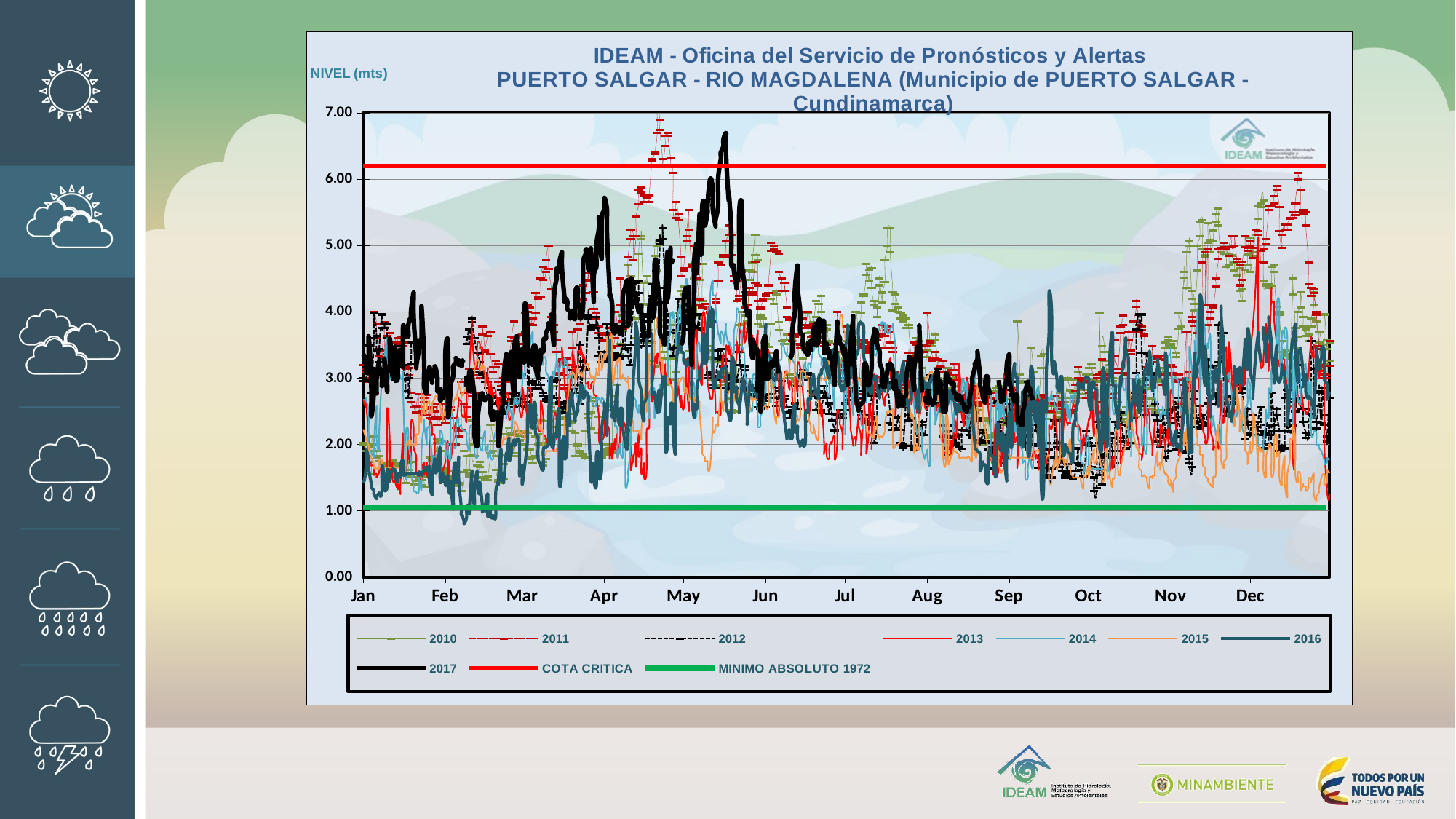
How many months are labelled along the x axis of the chart? 12 Is the highest value of the 2017 series greater or less than 7.00? less Which station and river does the chart title refer to? PUERTO SALGAR - RIO MAGDALENA Which is higher: the COTA CRITICA line or the MINIMO ABSOLUTO 1972 line? COTA CRITICA Is the highest value of the 2017 series greater or less than 6.00? greater Is the MINIMO ABSOLUTO 1972 line greater or less than 2.00? less In which month does the 2017 series reach its highest value? May How many entries does the chart legend list? 10 Does the 2017 series rise or fall from January to its peak in May? rise What kind of chart is shown on the slide? line chart What is the label of the y axis of the chart? NIVEL (mts)